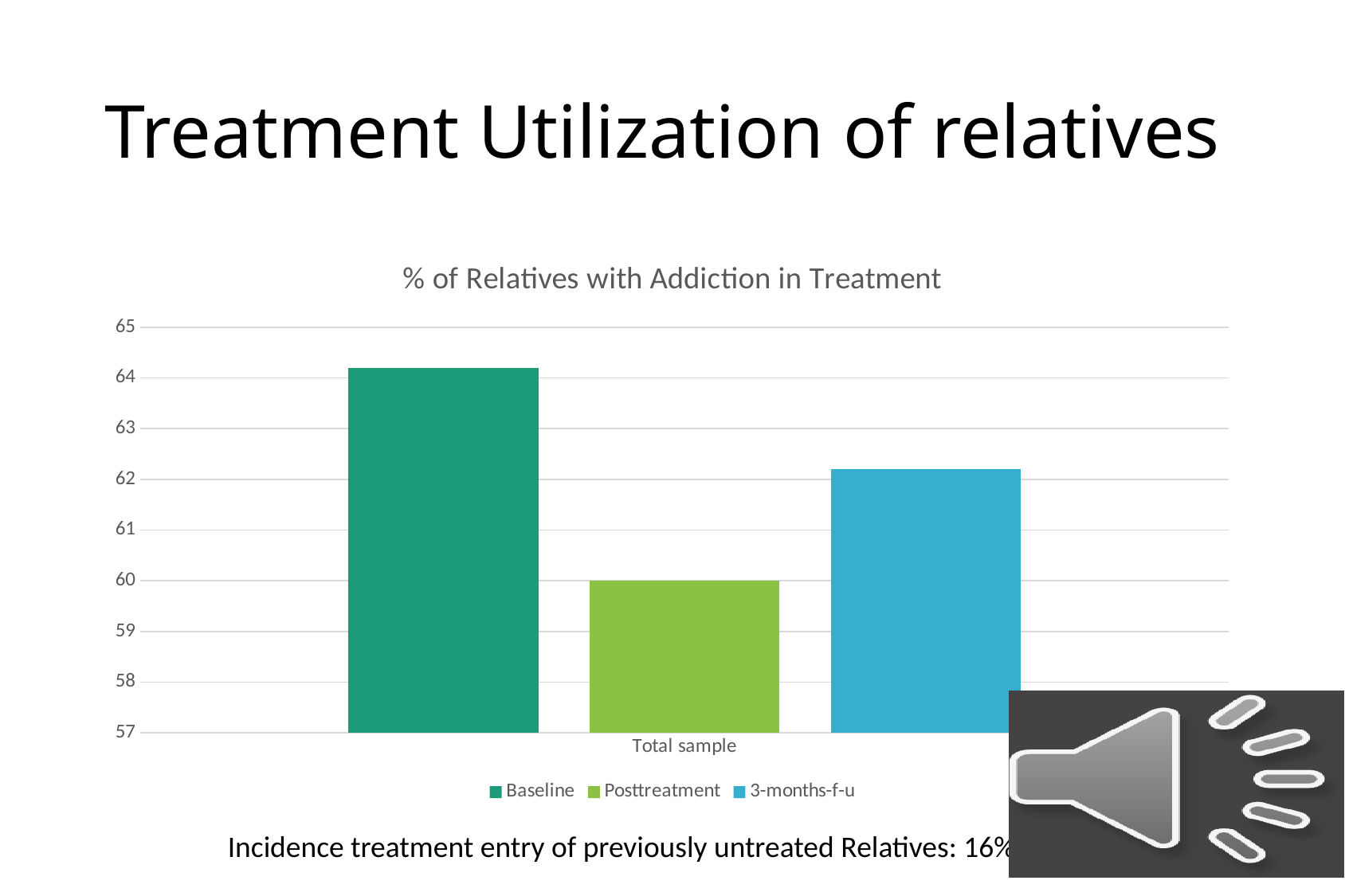
Is the value for Baseline greater or less than 64? greater What is the value for Posttreatment in the Total sample? 60 What is the title of the chart? % of Relatives with Addiction in Treatment What is the label of the category on the x axis? Total sample How many categories are shown on the x axis? 1 Is the value for 3-months-f-u greater or less than 62? greater Which series has the highest value for Total sample? Baseline What kind of chart is shown on the slide? bar chart How many series does the legend list? 3 Is the value for 3-months-f-u greater or less than 63? less Which is larger, the Baseline value or the 3-months-f-u value? Baseline Which series has the lowest value for Total sample? Posttreatment